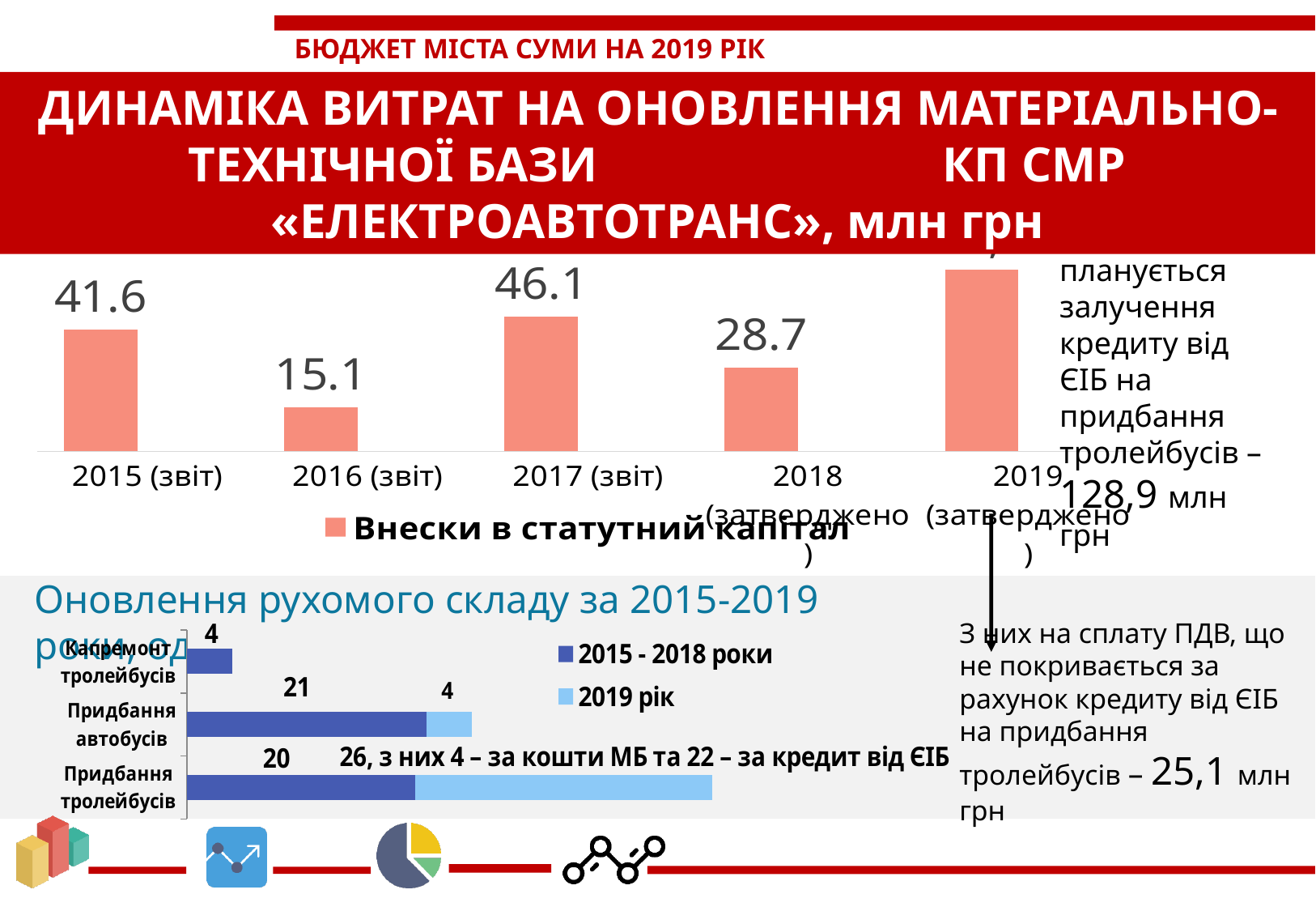
In the top chart (Внески в статутний капітал), which is larger: the value for 2015 (звіт) or 2018 (затверджено)? 2015 (звіт) In the top chart (Внески в статутний капітал), what is the value for 2015 (звіт)? 41.6 In the top chart (Внески в статутний капітал), what is the value for 2018 (затверджено)? 28.7 What kind of chart is the bottom chart (Оновлення рухомого складу за 2015-2019 роки)? Bar chart In the top chart (Внески в статутний капітал), which year has the tallest bar? 2019 (затверджено) In the bottom chart (Оновлення рухомого складу за 2015-2019 роки), what is the 2019 рік value for Придбання тролейбусів? 26 In the top chart (Внески в статутний капітал), what is the difference between the 2017 (звіт) and 2016 (звіт) values? 31.0 In the top chart (Внески в статутний капітал), what is the value for 2017 (звіт)? 46.1 In the top chart (Внески в статутний капітал), which year has the lowest value? 2016 (звіт) In the bottom chart (Оновлення рухомого складу за 2015-2019 роки), how many series does the legend list? 2 In the bottom chart (Оновлення рухомого складу за 2015-2019 роки), what is the total of the stacked bar for Придбання тролейбусів? 46 In the bottom chart (Оновлення рухомого складу за 2015-2019 роки), what is the 2015 - 2018 роки value for Придбання автобусів? 21